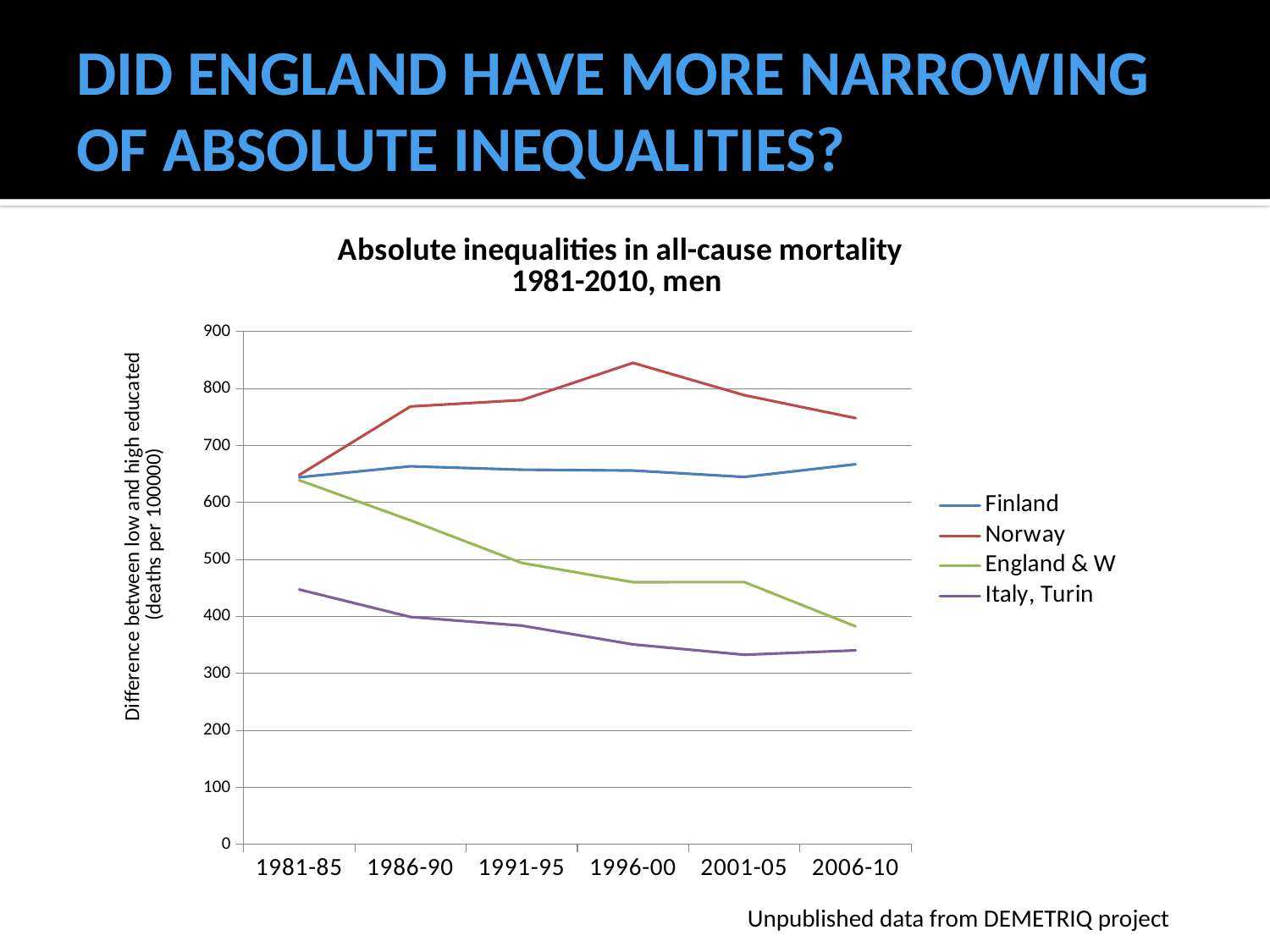
Is the value for England & W in 2006-10 greater or less than 400? less How many time periods are shown on the x axis? 6 How many series does the legend list? 4 Is the value for Norway in 1996-00 greater or less than 800? greater Does the England & W line rise or fall from 1981-85 to 2006-10? Fall Which series has the highest value in 1996-00? Norway What kind of chart is shown on the slide? Line chart Which series has the lowest value in 2006-10? Italy, Turin Is the value for Italy, Turin in 2001-05 greater or less than 400? less In 2006-10, which is larger: the value for Finland or the value for Norway? Norway What is the title of the chart? Absolute inequalities in all-cause mortality 1981-2010, men In which period does the Norway line reach its highest point? 1996-00